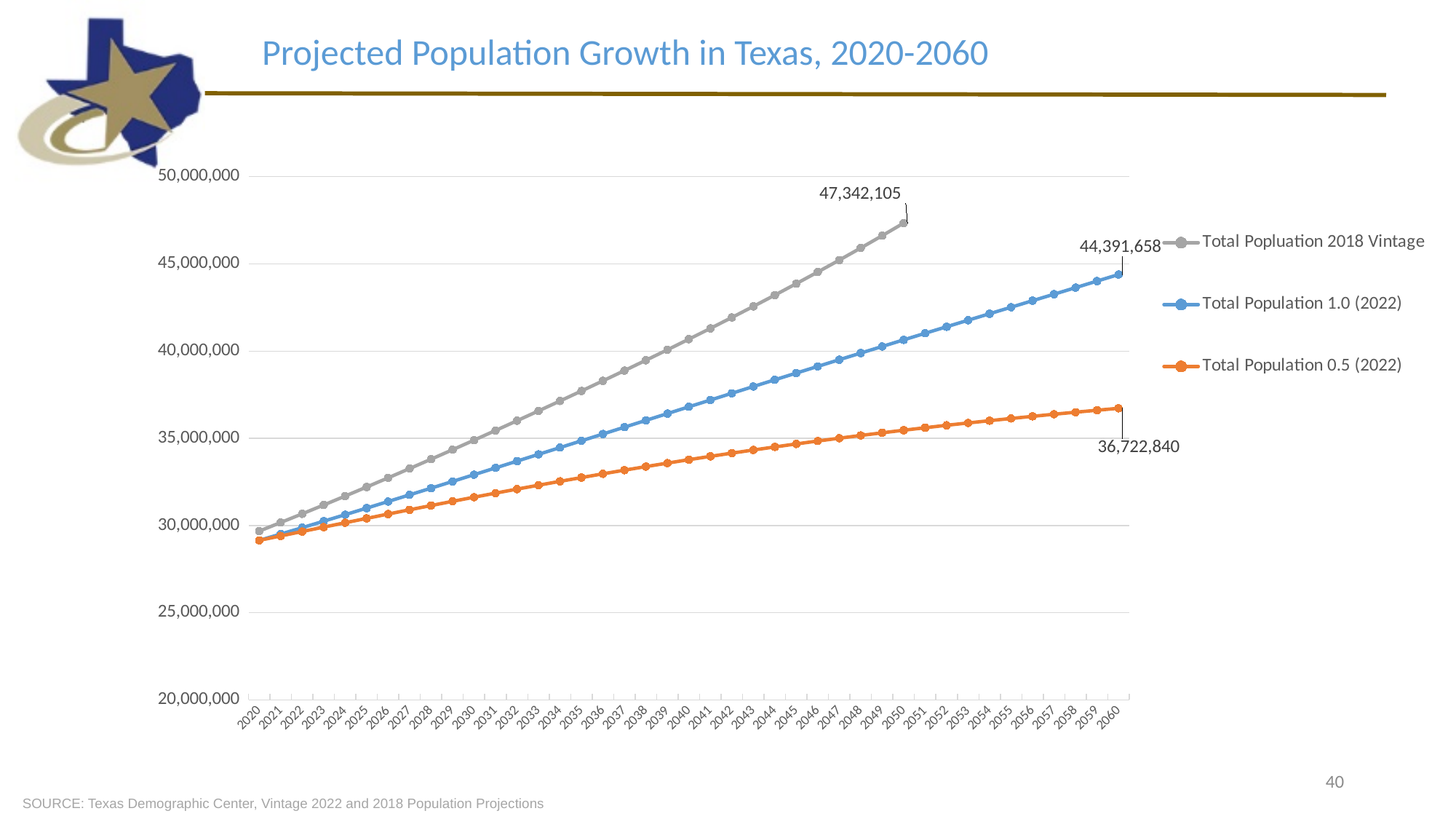
What is the labelled value of the Total Population 1.0 (2022) series in 2060? 44,391,658 How many years are shown on the x axis? 41 What is the labelled value of the Total Population 0.5 (2022) series in 2060? 36,722,840 Which series has the larger value in 2060: Total Population 1.0 (2022) or Total Population 0.5 (2022)? Total Population 1.0 (2022) What kind of chart is shown on the slide? line chart Is the value for Total Popluation 2018 Vintage in 2045 greater or less than 40,000,000? greater What is the difference between the 2060 values of Total Population 1.0 (2022) and Total Population 0.5 (2022)? 7,668,818 Is the value for Total Population 0.5 (2022) in 2040 greater or less than 35,000,000? less Does the Total Popluation 2018 Vintage series rise or fall from 2020 to 2050? rise Is the value for Total Population 1.0 (2022) in 2030 greater or less than 35,000,000? less How many series does the legend list? 3 What is the labelled value of the Total Popluation 2018 Vintage series at its final point in 2050? 47,342,105